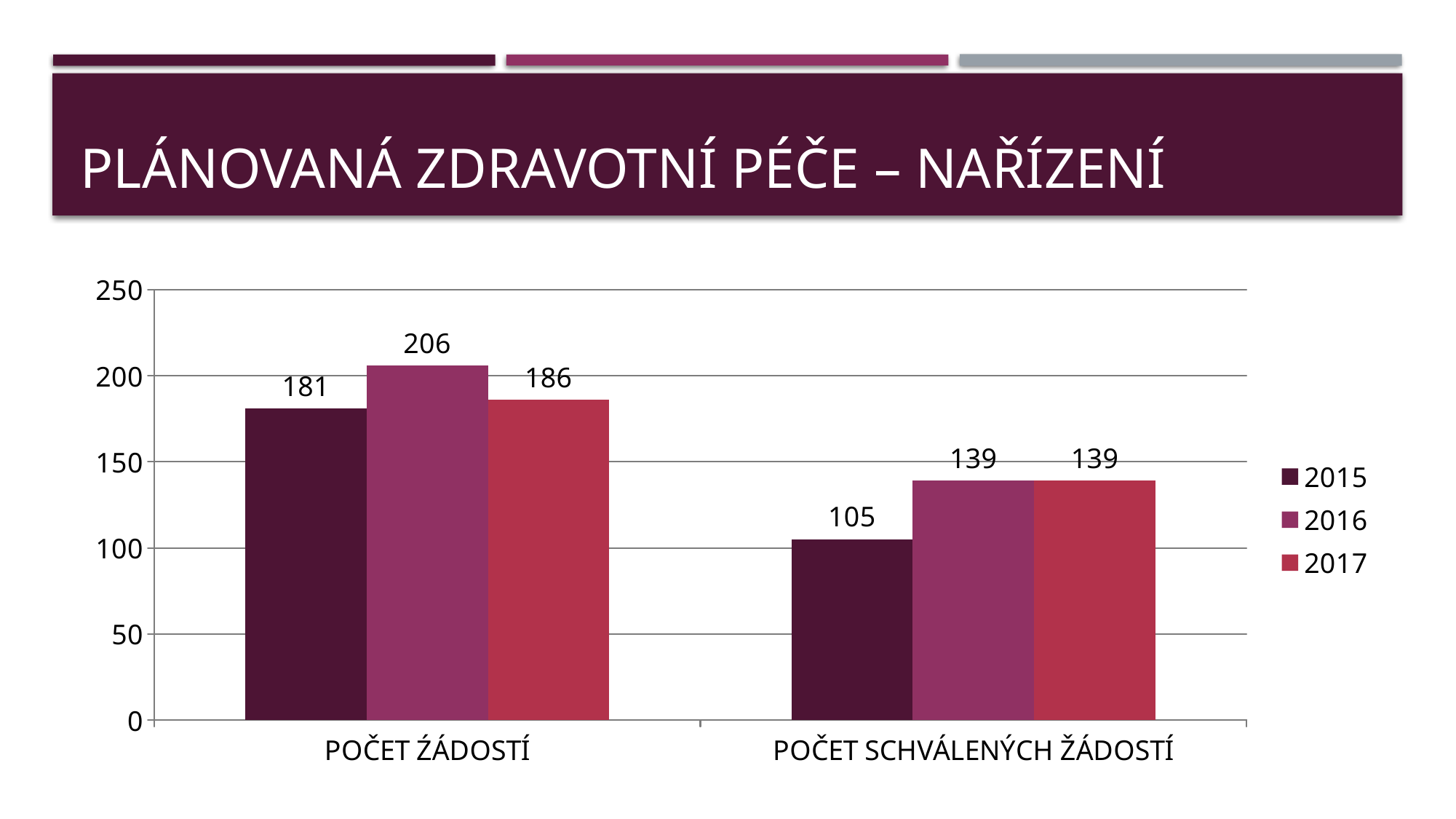
What is the value for 2016 in the POČET ŽÁDOSTÍ category? 206 What is the difference between the 2016 and 2015 values in the POČET ŽÁDOSTÍ category? 25 Is the 2015 value for POČET SCHVÁLENÝCH ŽÁDOSTÍ greater or less than 150? less How many categories are shown on the x axis? 2 Which year has the highest value in the POČET ŽÁDOSTÍ category? 2016 Which year has the lowest value in the POČET SCHVÁLENÝCH ŽÁDOSTÍ category? 2015 What is the difference between the 2016 and 2015 values in the POČET SCHVÁLENÝCH ŽÁDOSTÍ category? 34 What is the value for 2015 in the POČET SCHVÁLENÝCH ŽÁDOSTÍ category? 105 How many series does the legend list? 3 Which is larger: the 2015 value for POČET ŽÁDOSTÍ or the 2017 value for POČET SCHVÁLENÝCH ŽÁDOSTÍ? 2015 value for POČET ŽÁDOSTÍ What is the value for 2017 in the POČET ŽÁDOSTÍ category? 186 What kind of chart is shown on the slide? bar chart